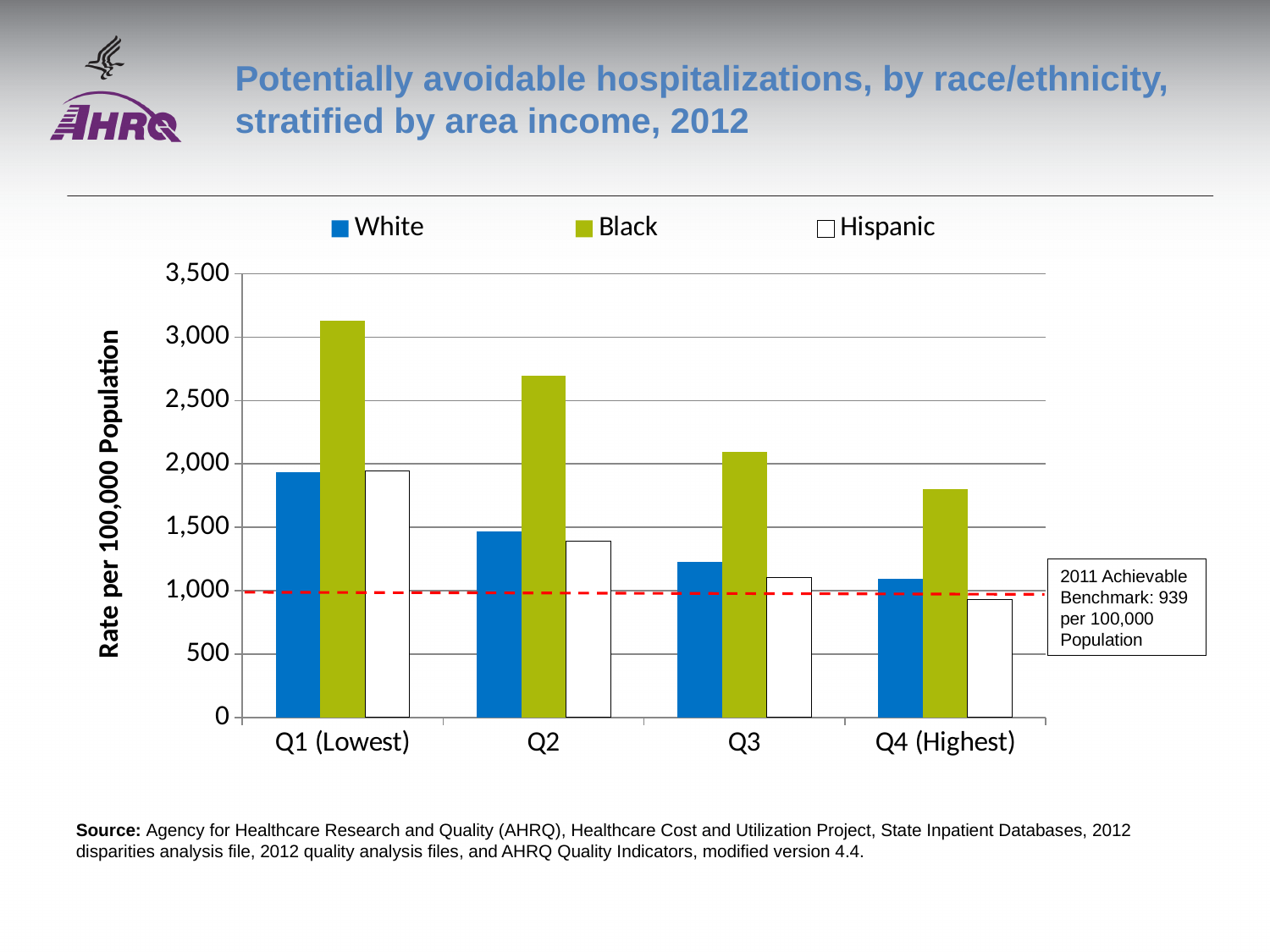
Do the rates for Black rise or fall from Q1 (Lowest) to Q4 (Highest)? fall Which income quartile has the lowest rate for Black? Q4 (Highest) Is the value for Black in Q2 greater or less than 2,500? greater What kind of chart is shown on the slide? Bar chart Which income quartile has the highest rate for Black? Q1 (Lowest) How many income quartile categories are shown on the x axis? 4 Is the value for Hispanic in Q2 greater or less than 1,500? less What is the 2011 achievable benchmark shown on the chart? 939 per 100,000 Population How many series does the legend list? 3 In Q2, which is larger, the rate for White or the rate for Black? Black Is the value for White in Q3 greater or less than 1,000? greater